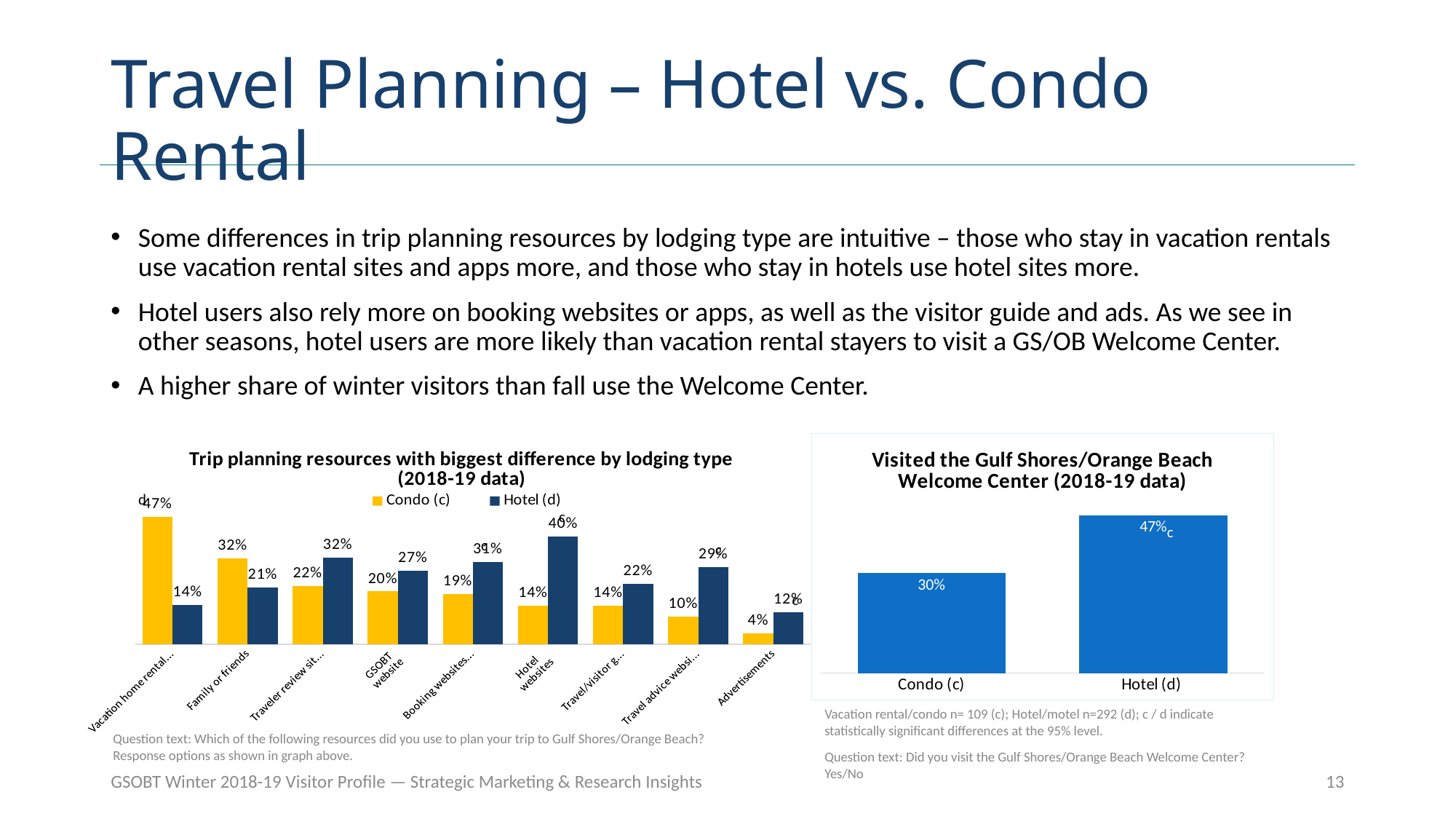
In the 'Visited the Gulf Shores/Orange Beach Welcome Center' chart, what is the difference between the Hotel (d) and Condo (c) values? 17 percentage points In the 'Trip planning resources with biggest difference by lodging type' chart, what is the difference between the Hotel (d) and Condo (c) values for Hotel websites? 26 percentage points In the 'Trip planning resources with biggest difference by lodging type' chart, which category has the lowest Condo (c) value? Advertisements In the 'Visited the Gulf Shores/Orange Beach Welcome Center' chart, what is the value for Hotel (d)? 47% In the 'Trip planning resources with biggest difference by lodging type' chart, which category has the highest Hotel (d) value? Hotel websites In the 'Trip planning resources with biggest difference by lodging type' chart, what is the Condo (c) value for Family or friends? 32% How many categories are shown on the x axis of the 'Trip planning resources with biggest difference by lodging type' chart? 9 In the 'Trip planning resources with biggest difference by lodging type' chart, what is the Hotel (d) value for Hotel websites? 40% In the 'Trip planning resources with biggest difference by lodging type' chart, what is the Condo (c) value for GSOBT website? 20% In the 'Trip planning resources with biggest difference by lodging type' chart, what is the Hotel (d) value for Advertisements? 12% In the 'Trip planning resources with biggest difference by lodging type' chart, which is larger for Family or friends: Condo (c) or Hotel (d)? Condo (c) How many series does the legend of the 'Trip planning resources with biggest difference by lodging type' chart list? 2